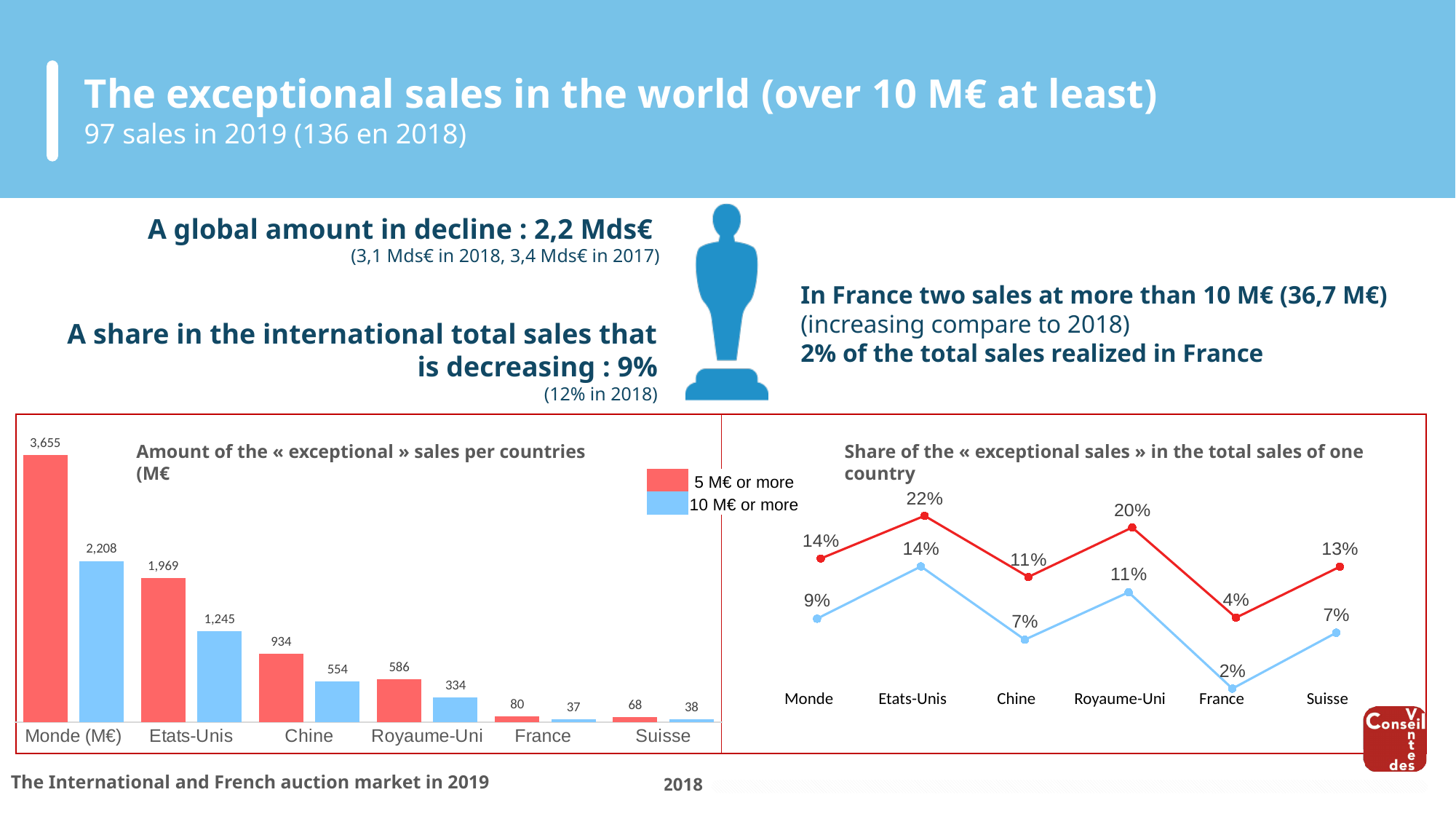
In the bar chart 'Amount of the « exceptional » sales per countries', what is the value of the '10 M€ or more' series for Chine? 554 How many countries are shown on the x axis of the line chart 'Share of the « exceptional sales » in the total sales of one country'? 6 What kind of chart is the chart on the right, 'Share of the « exceptional sales » in the total sales of one country'? line chart In the line chart 'Share of the « exceptional sales » in the total sales of one country', what is the value of the red line for Royaume-Uni? 20% In the bar chart 'Amount of the « exceptional » sales per countries', what is the difference between the '5 M€ or more' and '10 M€ or more' values for Royaume-Uni? 252 In the bar chart 'Amount of the « exceptional » sales per countries', what is the value of the '5 M€ or more' series for Etats-Unis? 1,969 In the line chart 'Share of the « exceptional sales » in the total sales of one country', which country has the highest value on the red line? Etats-Unis In the bar chart 'Amount of the « exceptional » sales per countries', which category has the highest '5 M€ or more' value? Monde (M€) In the bar chart 'Amount of the « exceptional » sales per countries', which is larger: the '5 M€ or more' value for France or for Suisse? France In the bar chart 'Amount of the « exceptional » sales per countries', which category has the lowest '10 M€ or more' value? France In the line chart 'Share of the « exceptional sales » in the total sales of one country', what is the value of the blue line for France? 2% How many series does the legend of the bar chart 'Amount of the « exceptional » sales per countries' list? 2